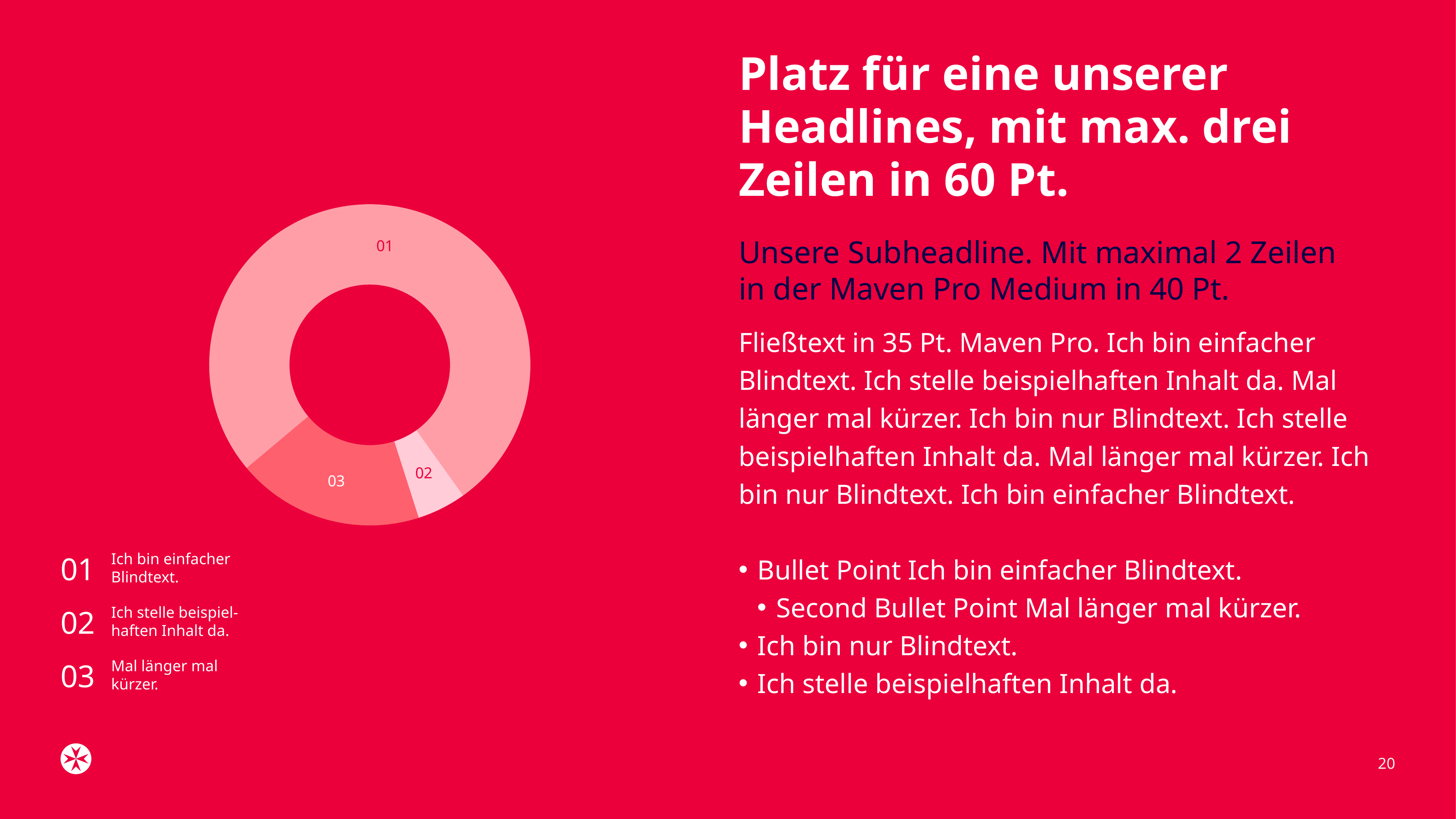
What kind of chart is shown on the left of the slide? donut chart Which segment of the donut chart is the smallest? 02 How many segments does the donut chart have? 3 What is the legend text for segment 03 of the donut chart? Mal länger mal kürzer. How many entries does the legend below the donut chart list? 3 Which segment is larger in the donut chart, 01 or 03? 01 Which segment of the donut chart is the largest? 01 Which segment is larger in the donut chart, 02 or 03? 03 What is the legend text for segment 01 of the donut chart? Ich bin einfacher Blindtext. Which segment is larger in the donut chart, 01 or 02? 01